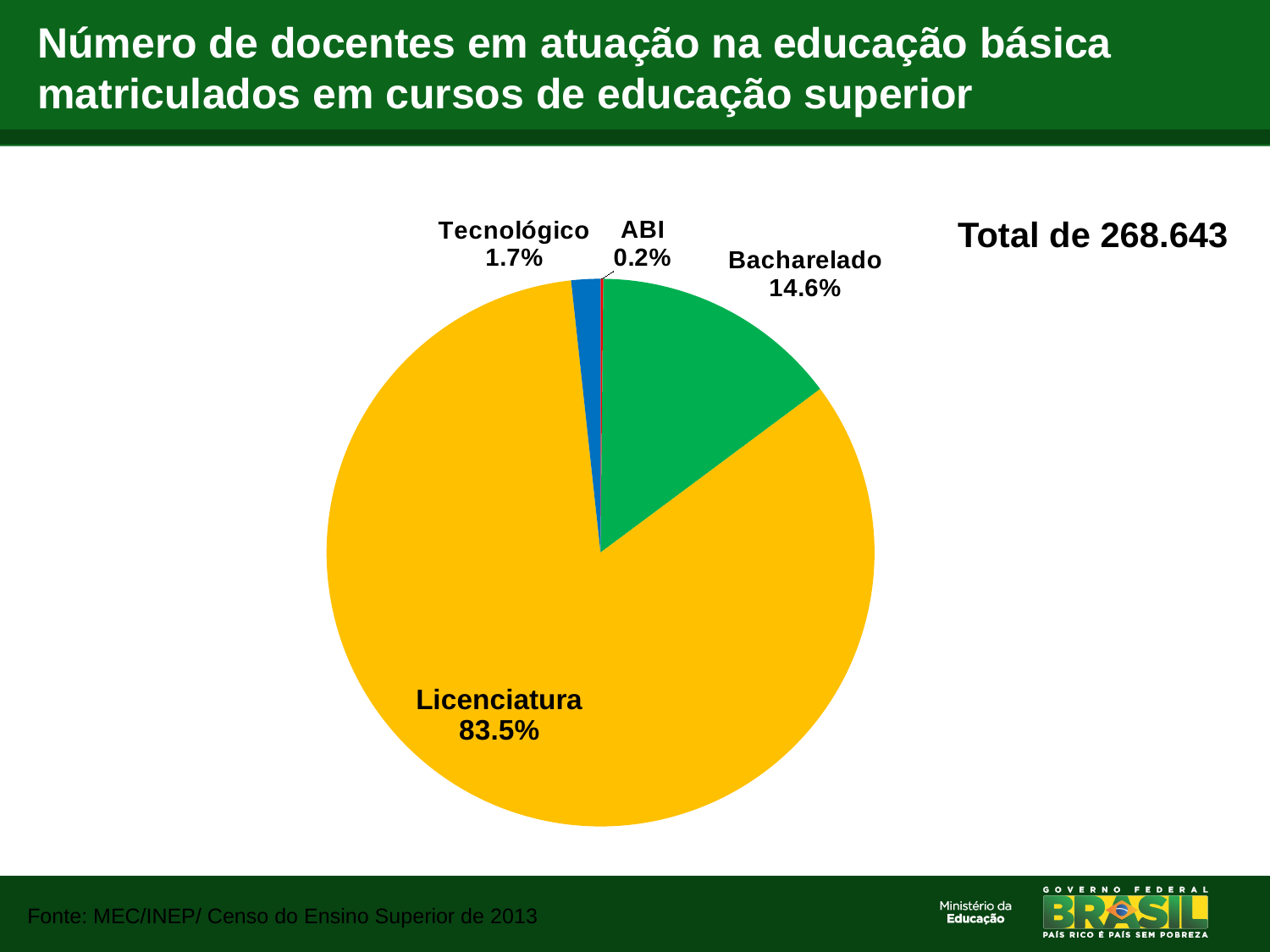
Which category has the smallest slice of the pie? ABI Which is larger, the share for Bacharelado or the share for Tecnológico? Bacharelado Which category has the largest slice of the pie? Licenciatura How many slices does the pie chart have? 4 What total is stated next to the pie chart? Total de 268.643 What share of the pie does Bacharelado represent? 14.6% What kind of chart is shown on the slide? pie chart What is the value shown for ABI? 0.2% What share of the pie does Licenciatura represent? 83.5% What is the difference in percentage points between Licenciatura and Bacharelado? 68.9 What is the difference in percentage points between Tecnológico and ABI? 1.5 What is the value shown for Tecnológico? 1.7%